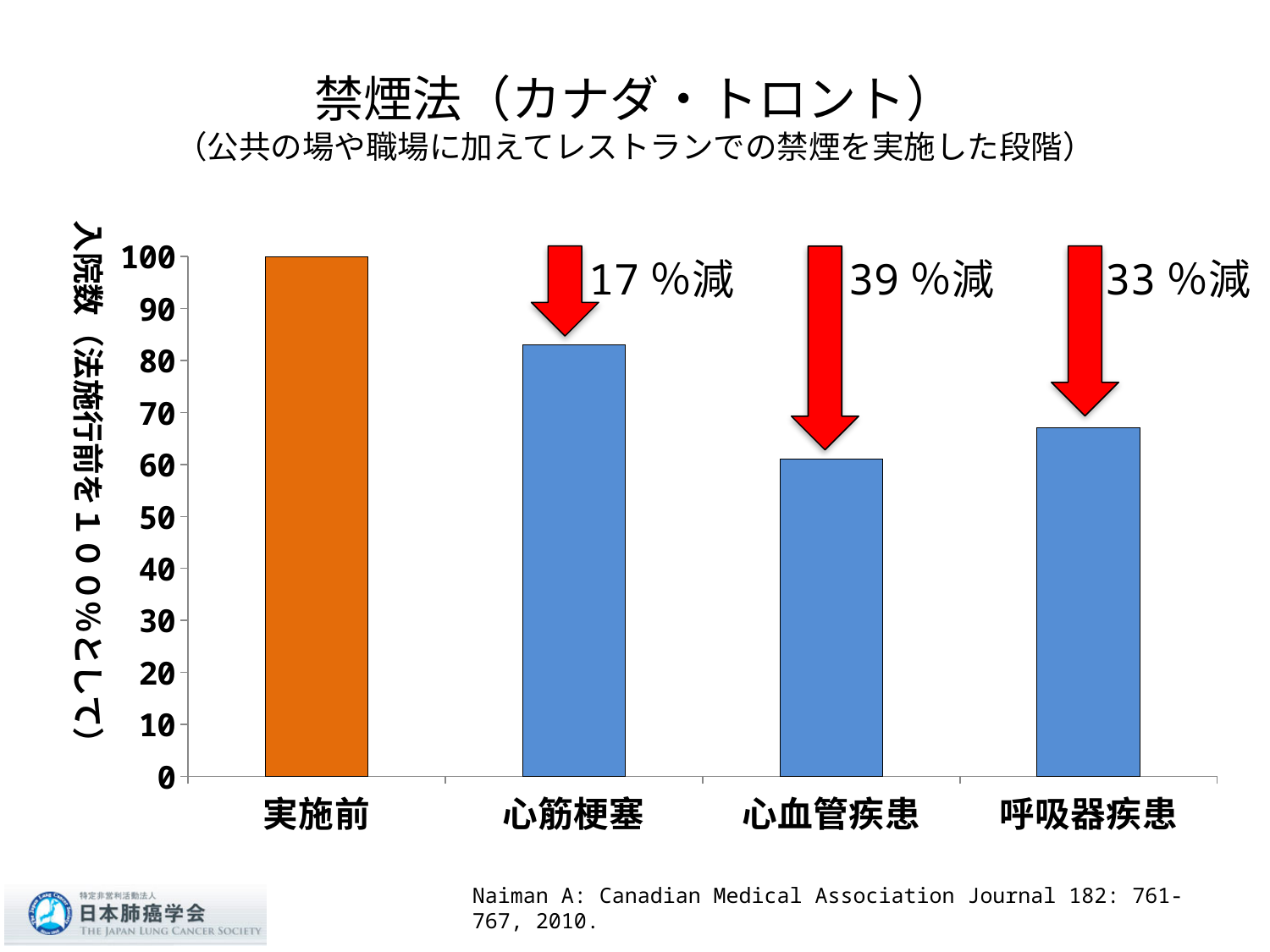
Which bar is taller, 心筋梗塞 or 呼吸器疾患? 心筋梗塞 What percentage reduction is annotated above the 心筋梗塞 bar? 17％減 How many bars (categories) are shown in the chart? 4 What percentage reduction is annotated above the 呼吸器疾患 bar? 33％減 What percentage reduction is annotated above the 心血管疾患 bar? 39％減 Is the value for 心筋梗塞 greater or less than 80? greater Is the value for 心血管疾患 greater or less than 70? less What kind of chart is shown on the slide? bar chart Which category has the highest bar? 実施前 Which category has the lowest bar? 心血管疾患 What colour is the 実施前 bar? orange What is the value of the 実施前 bar? 100